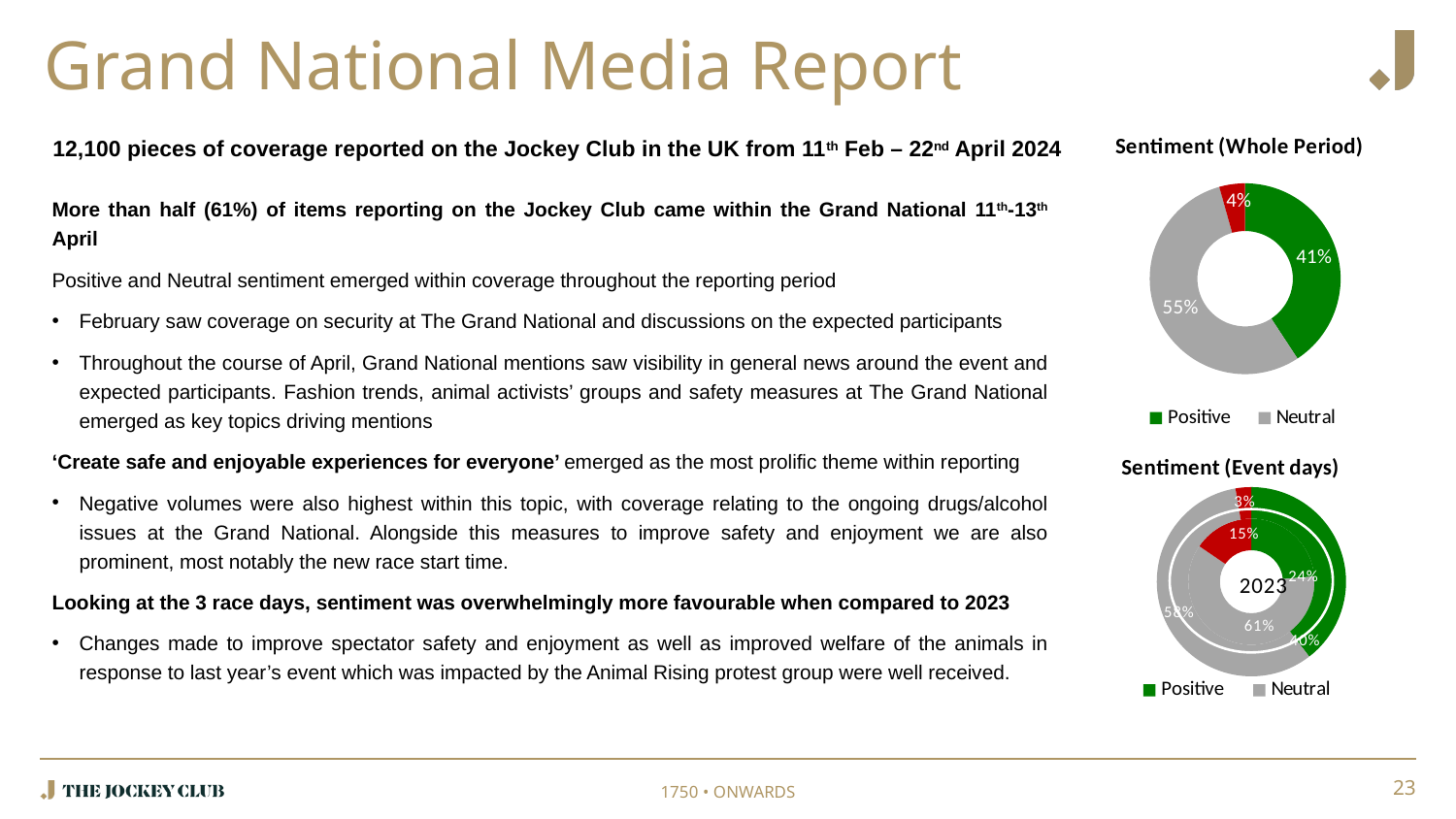
In the 'Sentiment (Whole Period)' chart, how many percentage points larger is the Neutral share than the Positive share? 14 percentage points In the 'Sentiment (Event days)' chart, which is larger: the Positive share in the inner 2023 ring or the Positive share in the outer ring? The outer ring In the 'Sentiment (Event days)' chart, what percentage is labelled for the green (Positive) segment of the outer ring? 40% In the 'Sentiment (Event days)' chart, what percentage is labelled for the green (Positive) segment of the inner 2023 ring? 24% In the 'Sentiment (Whole Period)' chart, which legend category has the largest share? Neutral In the 'Sentiment (Whole Period)' chart, what percentage is labelled on the small red slice? 4% In the 'Sentiment (Event days)' chart, what percentage is labelled for the grey (Neutral) segment of the inner 2023 ring? 61% In the 'Sentiment (Whole Period)' chart, what percentage is labelled for the Neutral slice? 55% In the 'Sentiment (Whole Period)' chart, what percentage is labelled for the Positive slice? 41% In the 'Sentiment (Event days)' chart, what percentage is labelled for the red segment of the inner 2023 ring? 15% What kind of chart is 'Sentiment (Whole Period)'? Pie (doughnut) chart How many entries does the legend of the 'Sentiment (Whole Period)' chart list? 2